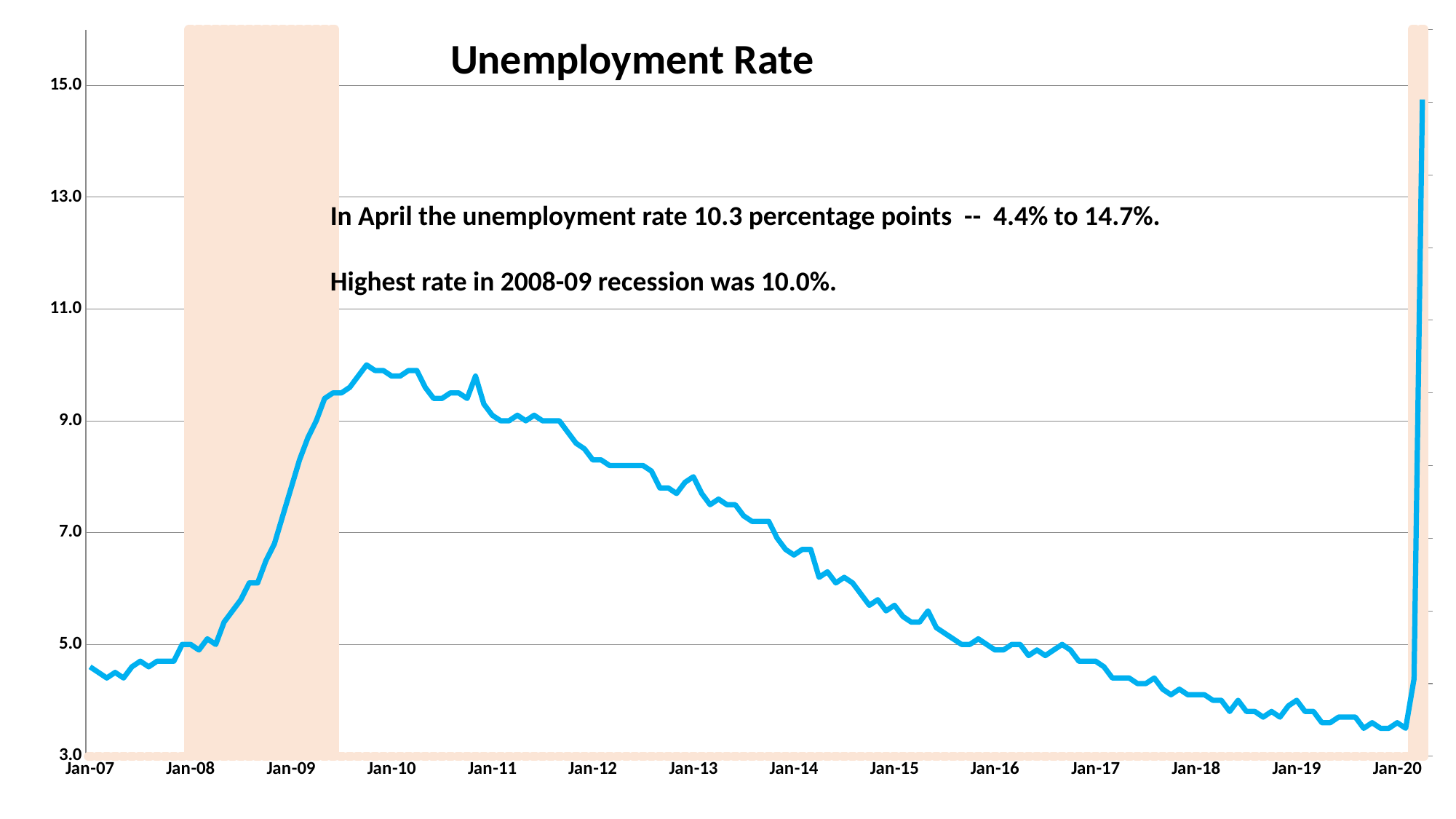
Between Jan-10 and Jan-19, does the unemployment rate generally rise or fall? fall According to the slide, what was the unemployment rate in April? 14.7% What kind of chart is shown on the slide? line chart Is the unemployment rate at Jan-07 greater or less than 5.0? less How many year labels are shown on the x axis? 14 Is the unemployment rate at Jan-13 greater or less than 7.0? greater According to the slide, what was the highest unemployment rate in the 2008-09 recession? 10.0% Is the unemployment rate at Jan-19 greater or less than 5.0? less What is the title of the chart? Unemployment Rate By how many percentage points did the unemployment rate rise in April, from 4.4% to 14.7%? 10.3 percentage points Which is higher, the unemployment rate at Jan-10 or at Jan-17? Jan-10